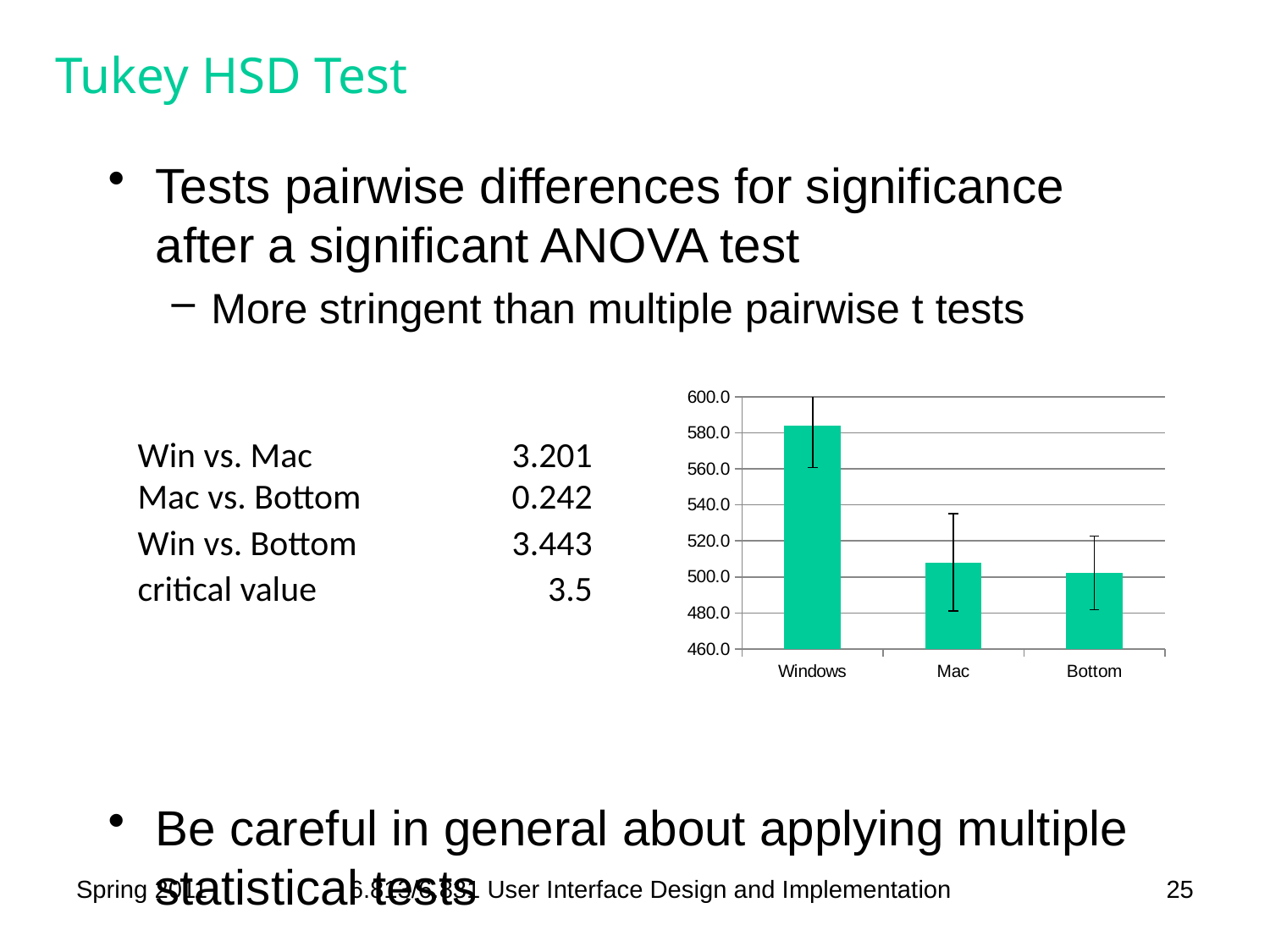
What kind of chart is shown on the slide? bar chart Which is larger, the value for Windows or the value for Bottom? Windows Is the value for Windows greater or less than 560? greater Is the value for Bottom greater or less than 480? greater Which category has the highest bar in the chart? Windows What is the lowest value shown on the chart's y axis? 460.0 Is the value for Bottom greater or less than 520? less Which is larger, the value for Windows or the value for Mac? Windows How many categories are plotted on the x axis of the chart? 3 What is the label of the first category on the x axis of the chart? Windows